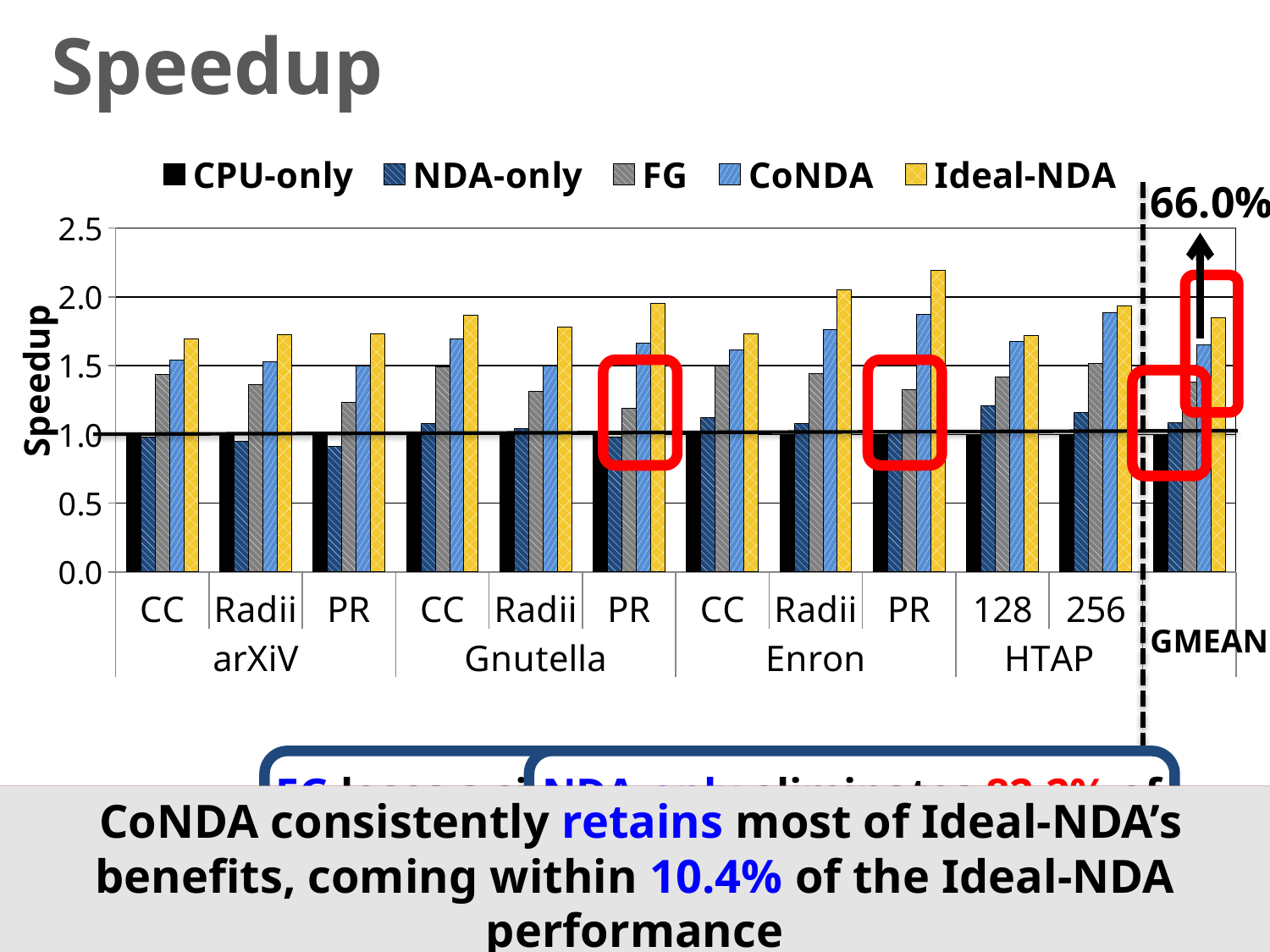
How many groups of bars are plotted along the x axis, including GMEAN? 12 Is the CoNDA value for 256 on HTAP greater or less than 1.5? greater Which series is listed last in the legend? Ideal-NDA Is the Ideal-NDA value for PR on Enron greater or less than 2.0? greater How many series does the legend list? 5 Is the FG value for PR on Enron greater or less than 1.5? less For PR on Gnutella, which is larger: the FG value or the CoNDA value? CoNDA What kind of chart is shown on the slide? bar chart What is the label on the vertical axis? Speedup What is the CPU-only speedup for CC on arXiV? 1.0 In which group does the Ideal-NDA series reach its highest value? PR on Enron